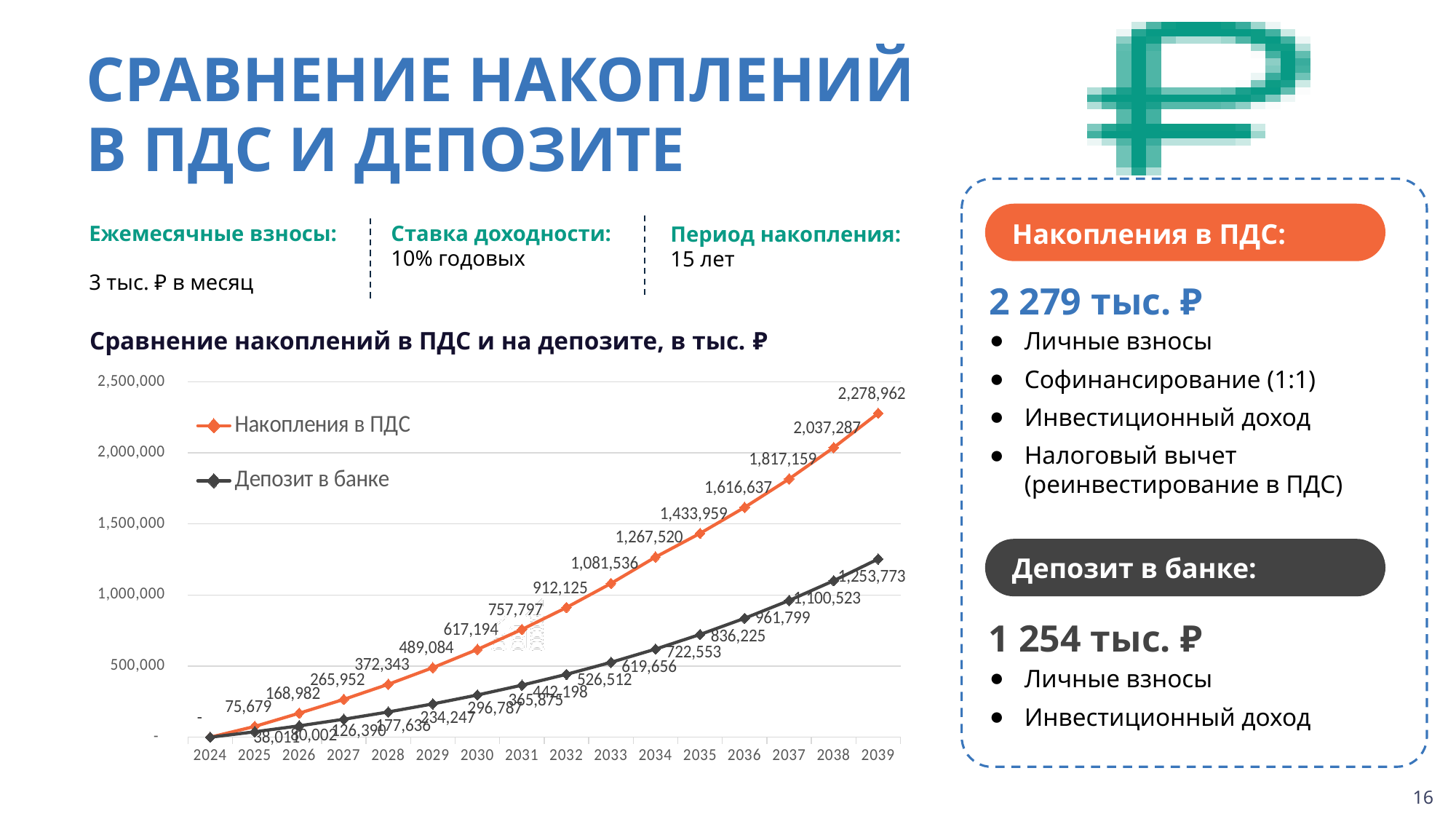
What is the value for Накопления в ПДС in 2039? 2,278,962 How many series does the chart legend list? 2 Which series has the larger value in 2035, Накопления в ПДС or Депозит в банке? Накопления в ПДС Do the values for Депозит в банке rise or fall from 2024 to 2039? rise Is the value for Депозит в банке in 2037 greater or less than 1,000,000? less What is the value for Накопления в ПДС in 2030? 617,194 What is the value for Депозит в банке in 2035? 722,553 What is the value for Депозит в банке in 2039? 1,253,773 What type of chart is shown on the slide? line chart How many years are shown on the x axis of the chart? 16 What is the difference between Накопления в ПДС and Депозит в банке in 2039? 1,025,189 In which year does Накопления в ПДС reach its highest value? 2039